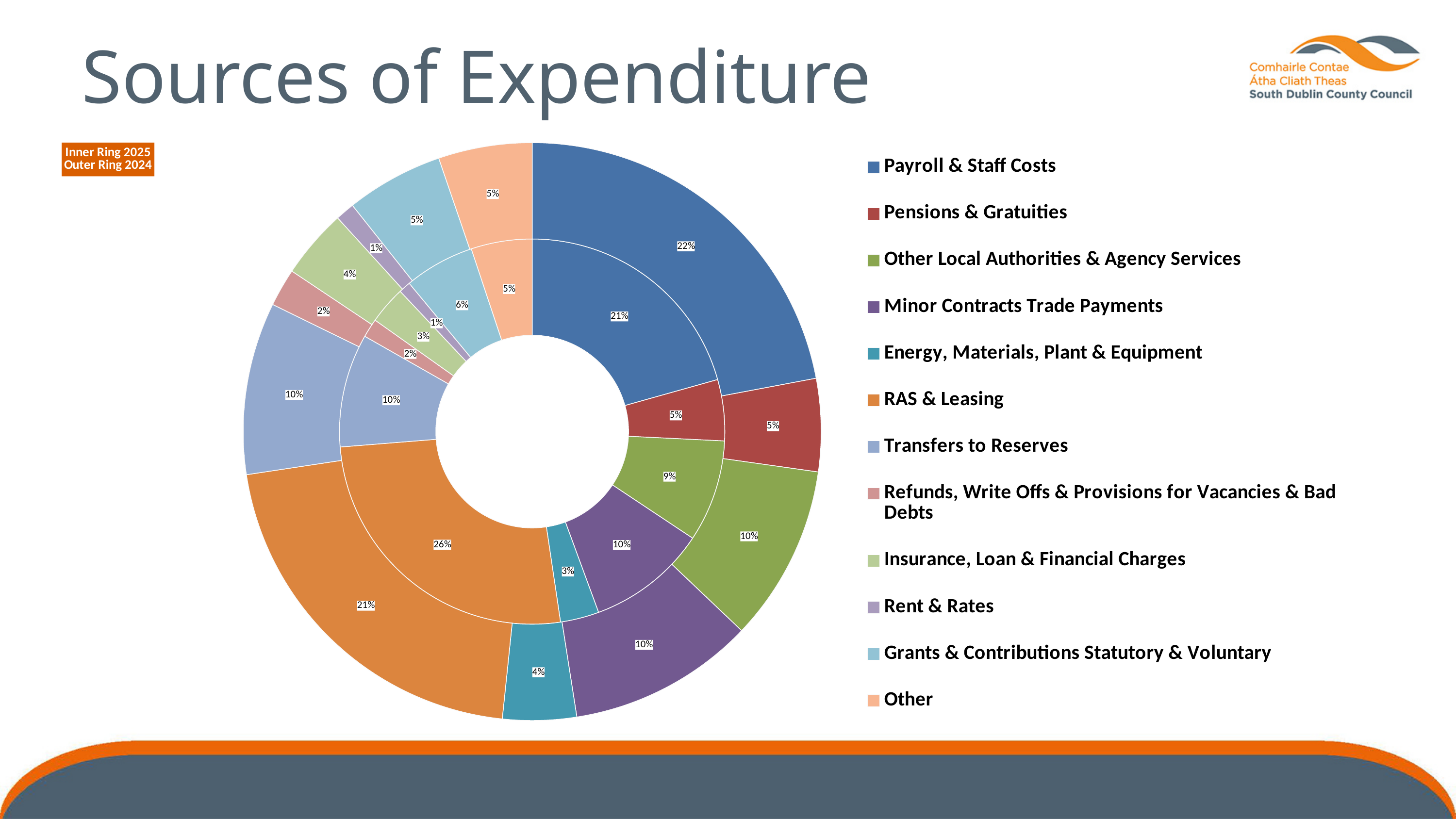
Which category has the smallest share in the outer ring (2024)? Rent & Rates Which year does the inner ring represent? 2025 What share of expenditure is Payroll & Staff Costs in the inner ring (2025)? 21% What share of expenditure is Payroll & Staff Costs in the outer ring (2024)? 22% What share of expenditure is RAS & Leasing in the inner ring (2025)? 26% By how many percentage points did the RAS & Leasing share change from the outer ring (2024) to the inner ring (2025)? 5 percentage points Which category has the largest share in the inner ring (2025)? RAS & Leasing Which is larger in the inner ring (2025): Grants & Contributions Statutory & Voluntary or Energy, Materials, Plant & Equipment? Grants & Contributions Statutory & Voluntary What kind of chart is shown on the slide? Doughnut (pie) chart What share of expenditure is RAS & Leasing in the outer ring (2024)? 21% How many categories does the legend list? 12 Which category has the largest share in the outer ring (2024)? Payroll & Staff Costs